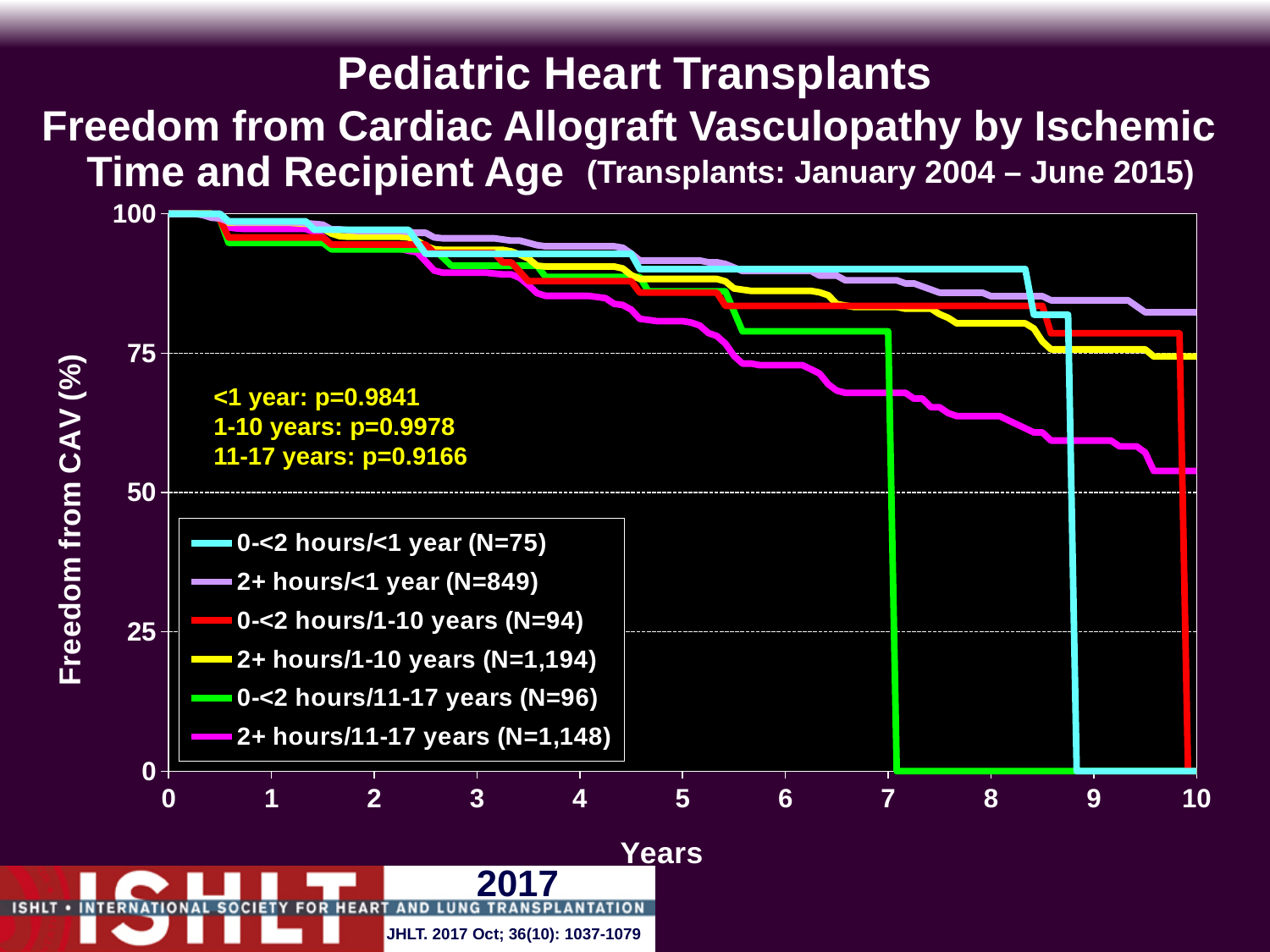
Is the value for 0-<2 hours/<1 year at year 8 greater or less than 75? greater What kind of chart is shown on the slide? line chart At year 10, which is higher: the 2+ hours/<1 year curve or the 2+ hours/11-17 years curve? 2+ hours/<1 year Is the value for 2+ hours/<1 year at year 10 greater or less than 75? greater Which series has the highest freedom from CAV at year 10? 2+ hours/<1 year (N=849) At year 9, which is higher: the 2+ hours/<1 year curve or the 2+ hours/1-10 years curve? 2+ hours/<1 year What p-value is shown for the 11-17 years comparison? p=0.9166 How many series does the legend list? 6 Is the value for 2+ hours/11-17 years at year 10 greater or less than 75? less What is the N for the 2+ hours/1-10 years series in the legend? N=1,194 Do the curves rise or fall as years increase along the x axis? fall